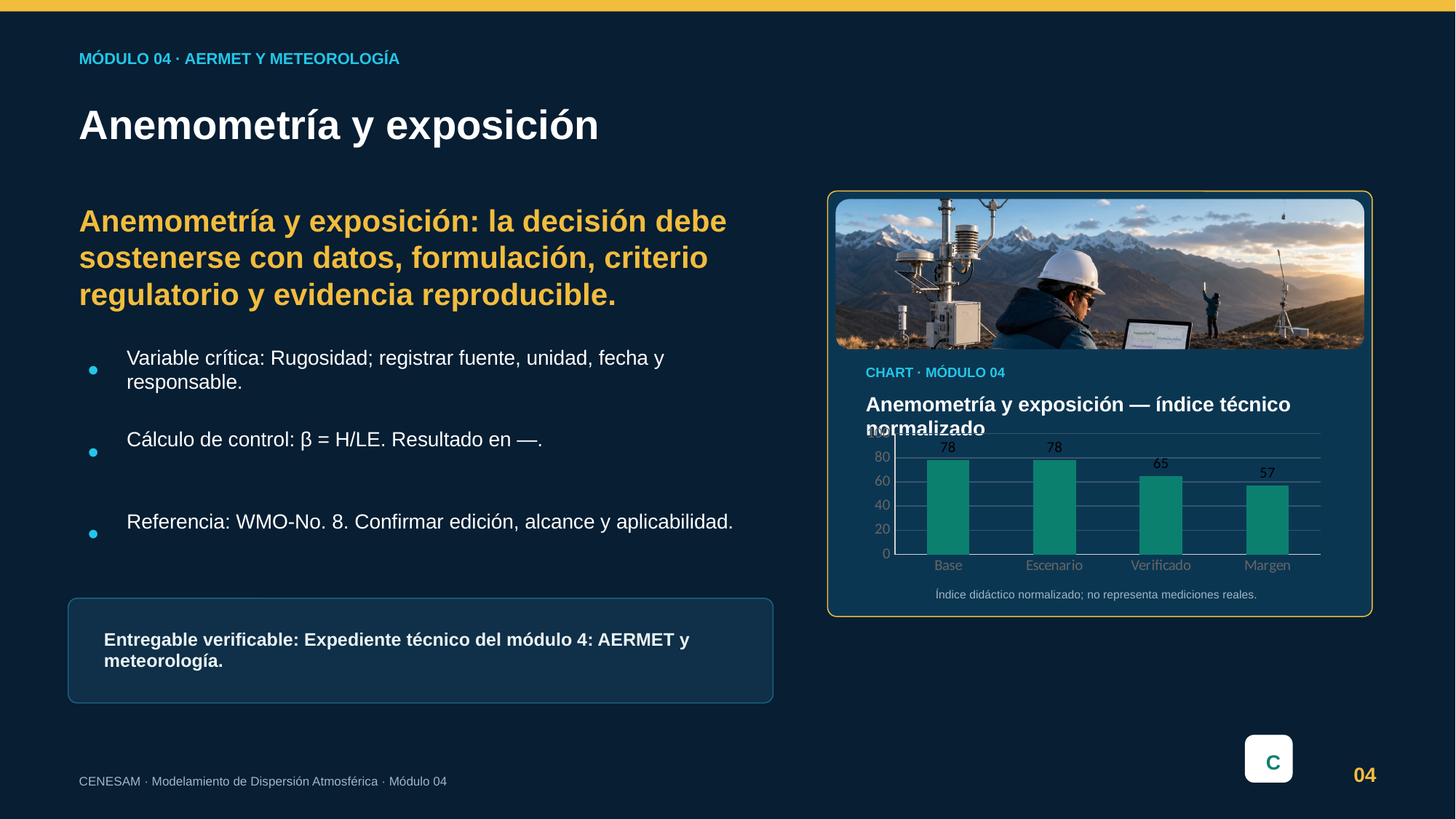
What is the difference between the values for Base and Verificado? 13 What is the value for Verificado? 65 What is the title of the chart? Anemometría y exposición — índice técnico normalizado What is the value for Base? 78 What kind of chart is shown on the slide? bar chart What is the value for Margen? 57 Which is larger, the value for Verificado or the value for Margen? Verificado What is the difference between the values for Escenario and Margen? 21 Which category has the lowest value? Margen Is the value for Margen greater or less than 60? less How many categories are shown on the x axis? 4 Do the values rise or fall from Escenario to Margen along the x axis? fall